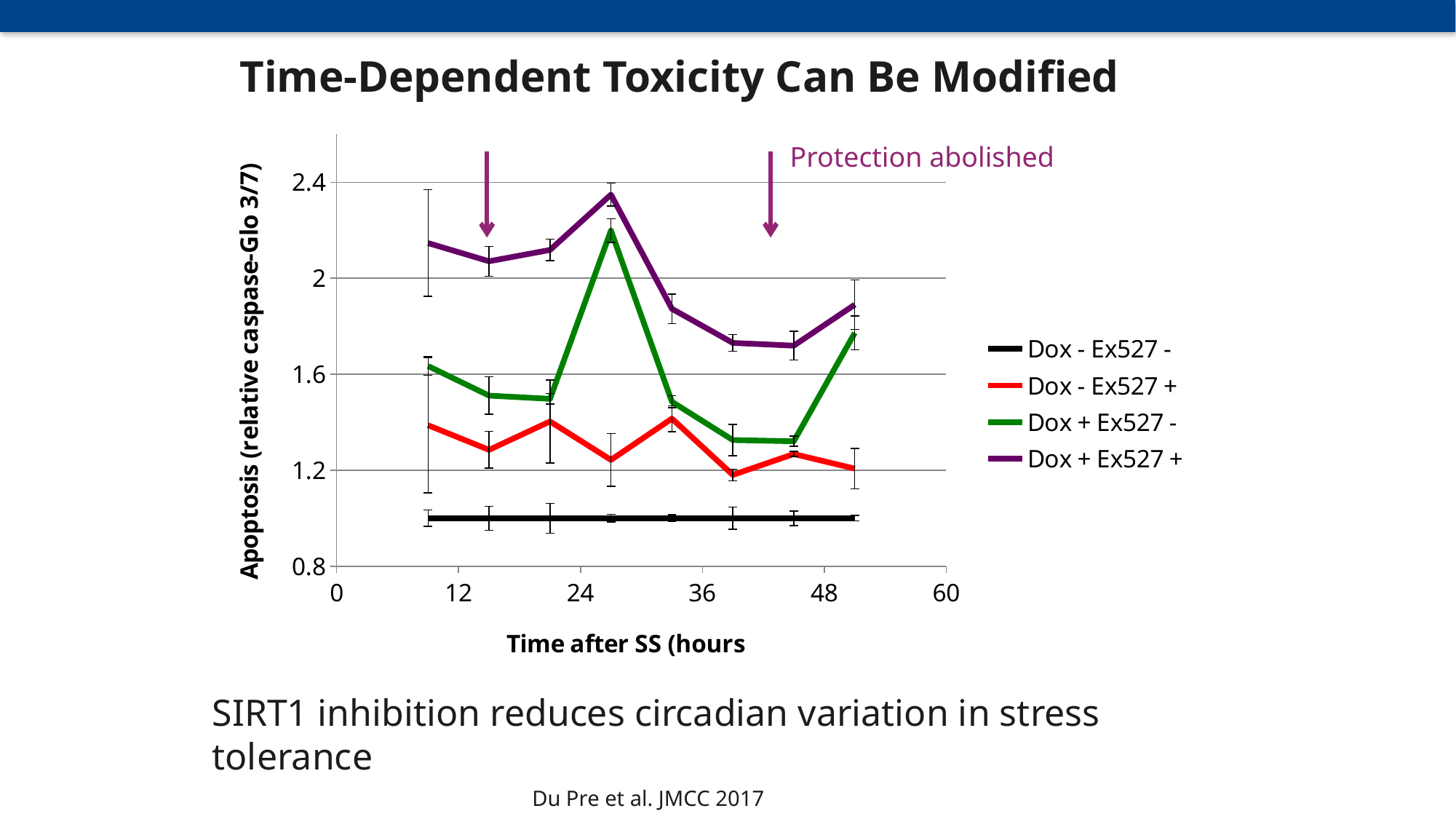
Which series has the lowest values across the whole time course? Dox - Ex527 - Which series is plotted with the purple line? Dox + Ex527 + Is the value of the Dox - Ex527 - series at 24 hours greater or less than 1.2? less How many series does the legend list? 4 At around 27 hours, which series has the larger value: Dox + Ex527 - or Dox - Ex527 +? Dox + Ex527 - Is the peak value of the Dox + Ex527 + series greater or less than 2? greater Is the value of the Dox - Ex527 + series at around 39 hours greater or less than 1.6? less Which series has the highest values across the whole time course? Dox + Ex527 + What is the label of the y axis? Apoptosis (relative caspase-Glo 3/7) What kind of chart is shown on the slide? line chart How many data points are plotted for each series? 8